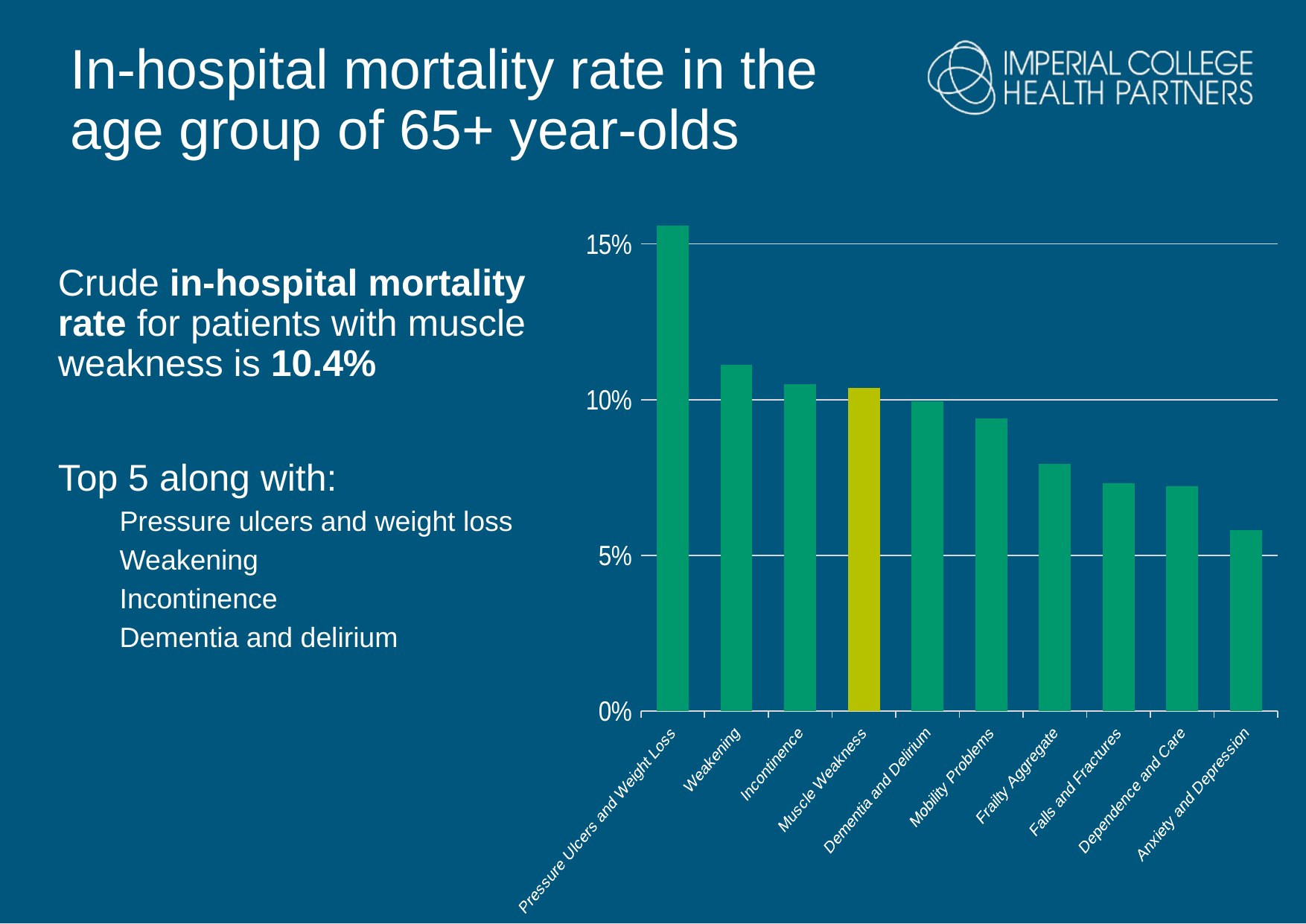
Which bar is shown in a different colour (yellow) from the others? Muscle Weakness What kind of chart is shown on the slide? Bar chart Which is larger, the value for Incontinence or the value for Frailty Aggregate? Incontinence What is the crude in-hospital mortality rate for patients with muscle weakness? 10.4% Is the value for Anxiety and Depression greater or less than 5%? greater Is the value for Weakening greater or less than 10%? greater Is the value for Pressure Ulcers and Weight Loss greater or less than 15%? greater Which category has the lowest in-hospital mortality rate? Anxiety and Depression Which category has the highest in-hospital mortality rate? Pressure Ulcers and Weight Loss How many categories are plotted on the chart? 10 Do the values rise or fall moving from left to right along the x axis? Fall